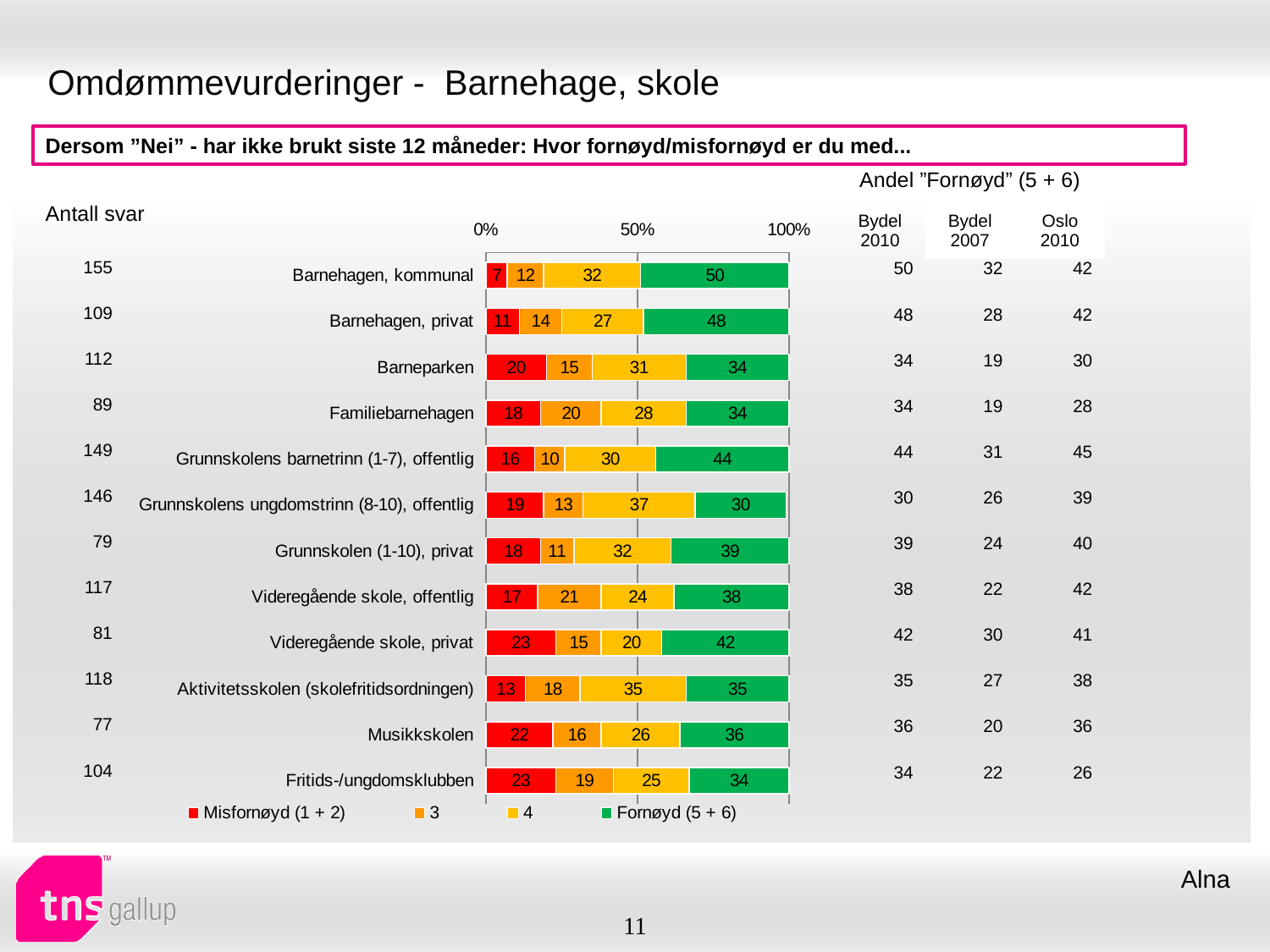
Which category has the lowest Fornøyd (5 + 6) value? Grunnskolens ungdomstrinn (8-10), offentlig How many series does the legend list? 4 What kind of chart is shown on the slide? Stacked bar chart Which category has the highest Fornøyd (5 + 6) value? Barnehagen, kommunal What is the value of the Misfornøyd (1 + 2) segment for Fritids-/ungdomsklubben? 23 What is the value of the Fornøyd (5 + 6) segment for Barnehagen, kommunal? 50 What is the value of the '4' segment for Grunnskolens ungdomstrinn (8-10), offentlig? 37 Which category has the lowest Misfornøyd (1 + 2) value? Barnehagen, kommunal Which has a larger Fornøyd (5 + 6) value: Barneparken or Grunnskolen (1-10), privat? Grunnskolen (1-10), privat What is the total of the stacked bar for Musikkskolen? 100 What is the difference between the Fornøyd (5 + 6) values for Barnehagen, kommunal and Barnehagen, privat? 2 How many categories are shown in the chart? 12